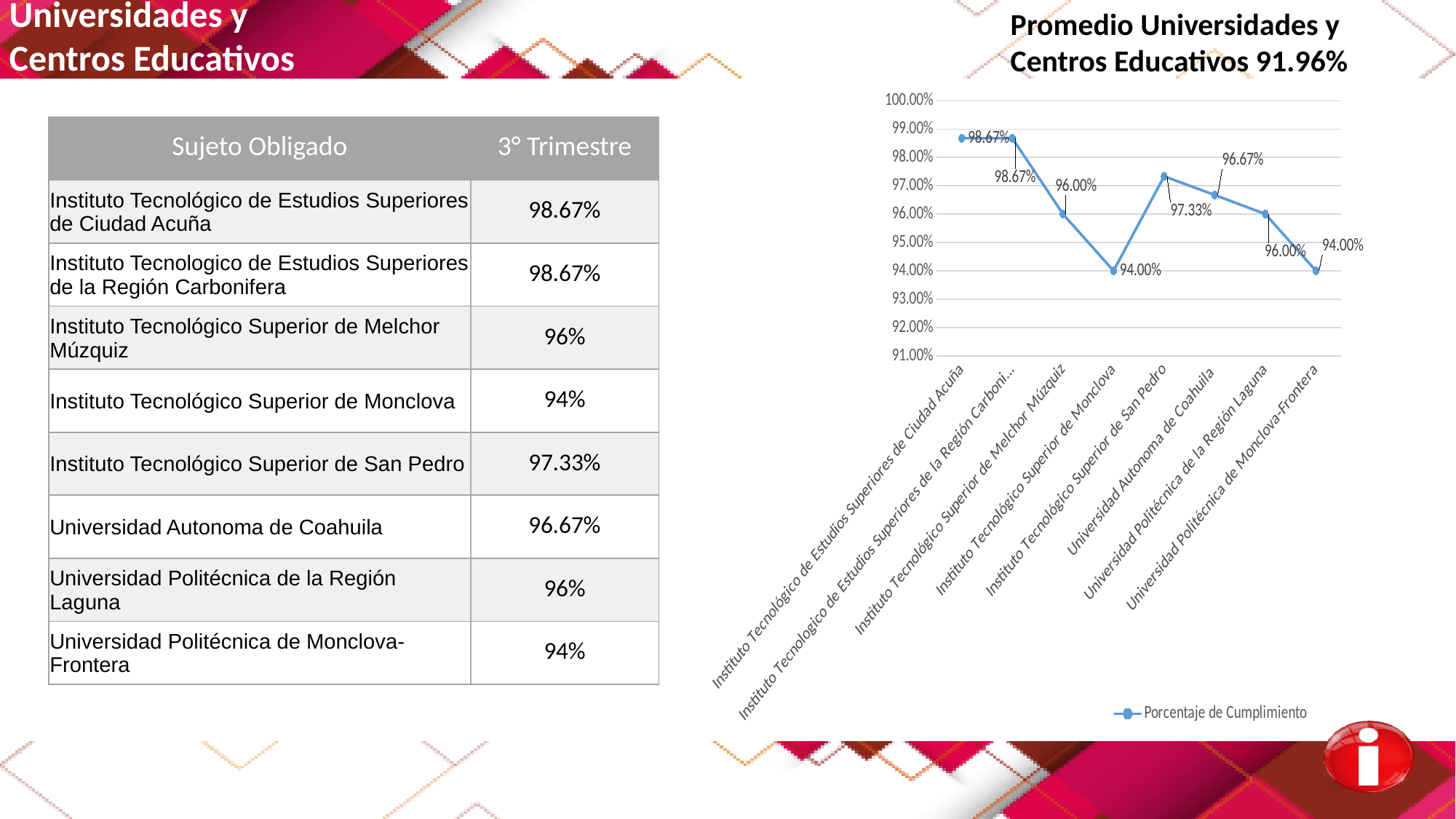
How many series does the chart legend list? 1 What is the value for Universidad Autonoma de Coahuila in the chart? 96.67% What kind of chart is shown on the slide? line chart What is the highest value plotted in the chart? 98.67% What is the value for Instituto Tecnológico Superior de Monclova in the chart? 94.00% Which has a higher value, Instituto Tecnológico Superior de San Pedro or Universidad Autonoma de Coahuila? Instituto Tecnológico Superior de San Pedro What is the lowest value plotted in the chart? 94.00% What is the difference between the values for Instituto Tecnológico de Estudios Superiores de Ciudad Acuña and Instituto Tecnológico Superior de Monclova? 4.67% Is the value for Universidad Politécnica de Monclova-Frontera greater or less than 95.00%? less How many categories are plotted in the chart? 8 What is the value for Universidad Politécnica de la Región Laguna in the chart? 96.00% What is the value for Instituto Tecnológico Superior de San Pedro in the chart? 97.33%